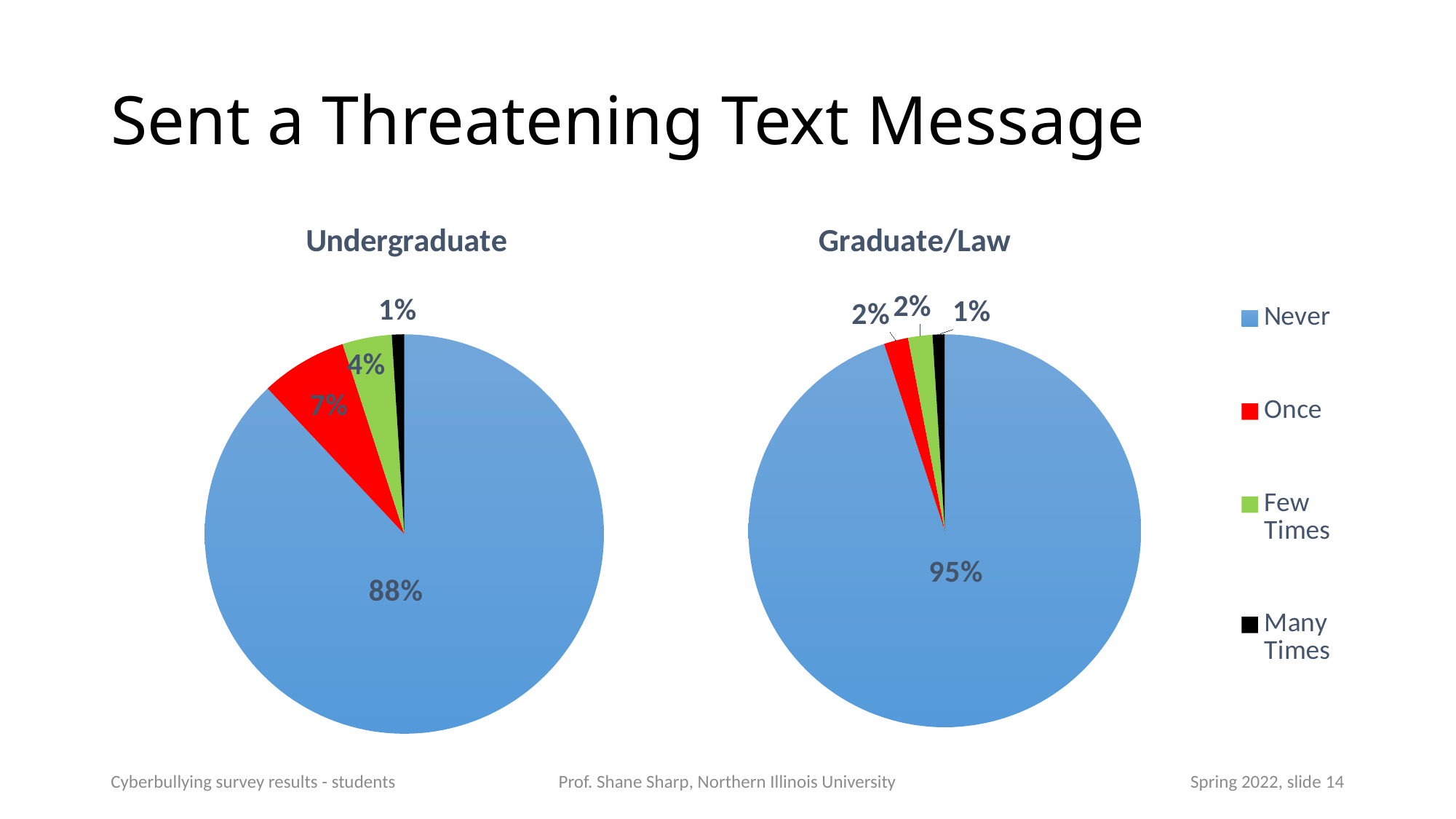
Which chart has the larger Once slice, Undergraduate or Graduate/Law? Undergraduate In the Undergraduate pie chart, what share is labelled for Once? 7% In the Undergraduate pie chart, what percentage of respondents answered Never? 88% In the Undergraduate pie chart, what share is labelled for Few Times? 4% What is the difference between the Never share in the Graduate/Law chart and the Never share in the Undergraduate chart? 7% In the Graduate/Law pie chart, what percentage of respondents answered Never? 95% What type of chart is used for the Undergraduate data? Pie chart In the legend, which colour represents Few Times? Green In the Graduate/Law pie chart, which category has the largest slice? Never How many categories does the legend list for the pie charts? 4 In the Undergraduate pie chart, which category has the smallest slice? Many Times In the Graduate/Law pie chart, what share is labelled for Many Times? 1%